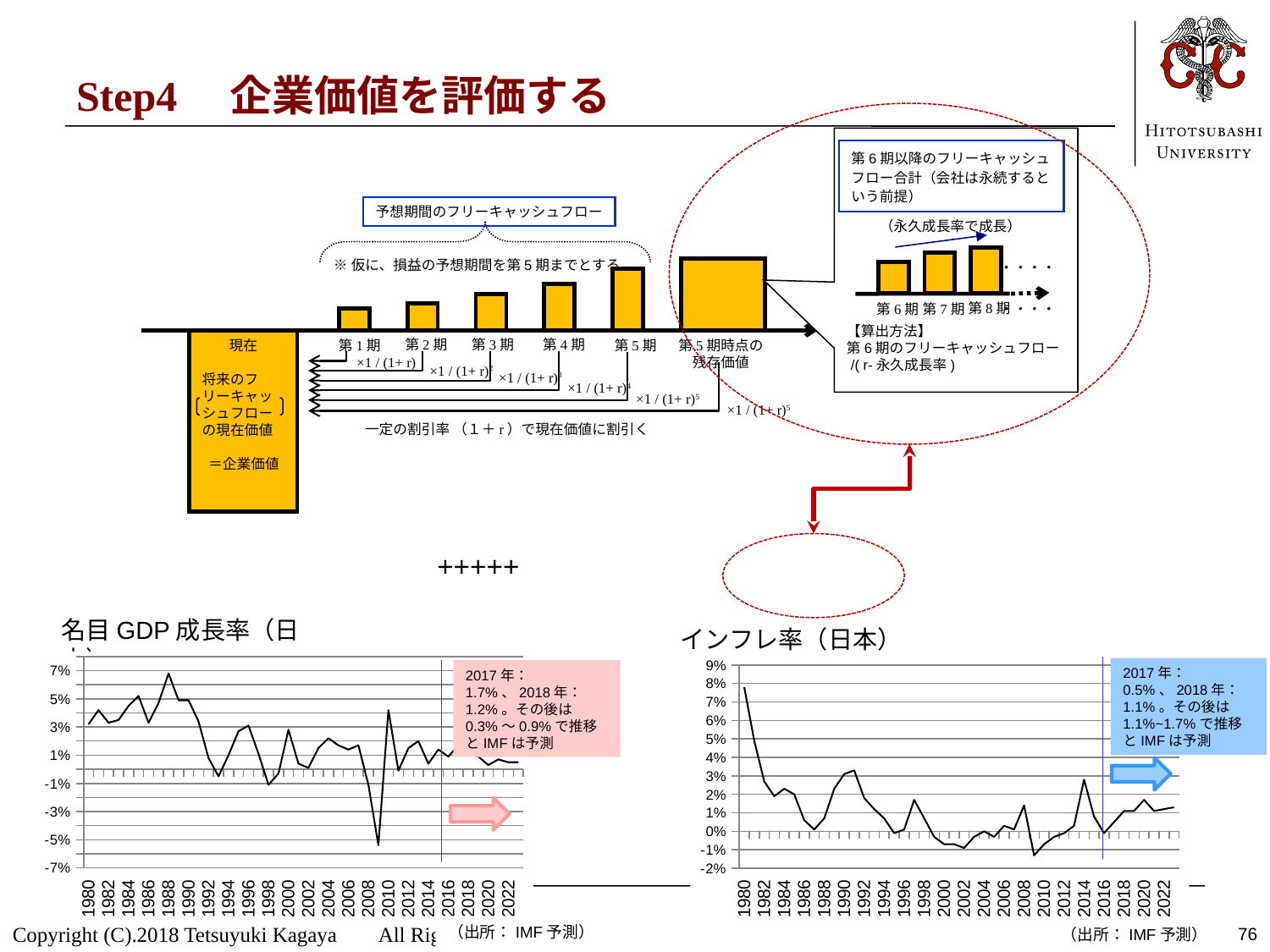
What kind of chart is the インフレ率（日本） chart? line chart In the 名目GDP成長率（日本） chart, is the value for 1988 greater or less than 5%? greater What is the lowest value shown on the y axis of the 名目GDP成長率（日本） chart? -7% In the インフレ率（日本） chart, which year has the highest value? 1980 In the 名目GDP成長率（日本） chart, which year has the lowest value? 2009 In the インフレ率（日本） chart, is the value for 1980 greater or less than 7%? greater In the 名目GDP成長率（日本） chart, is the value for 2009 greater or less than -3%? less In the インフレ率（日本） chart, do the values generally rise or fall from 1980 to 1987? fall What is the highest value shown on the y axis of the インフレ率（日本） chart? 9% According to the annotation on the インフレ率（日本） chart, what is the inflation rate for 2018? 1.1% What kind of chart is the 名目GDP成長率（日本） chart? line chart According to the annotation on the 名目GDP成長率（日本） chart, what is the nominal GDP growth rate for 2017? 1.7%